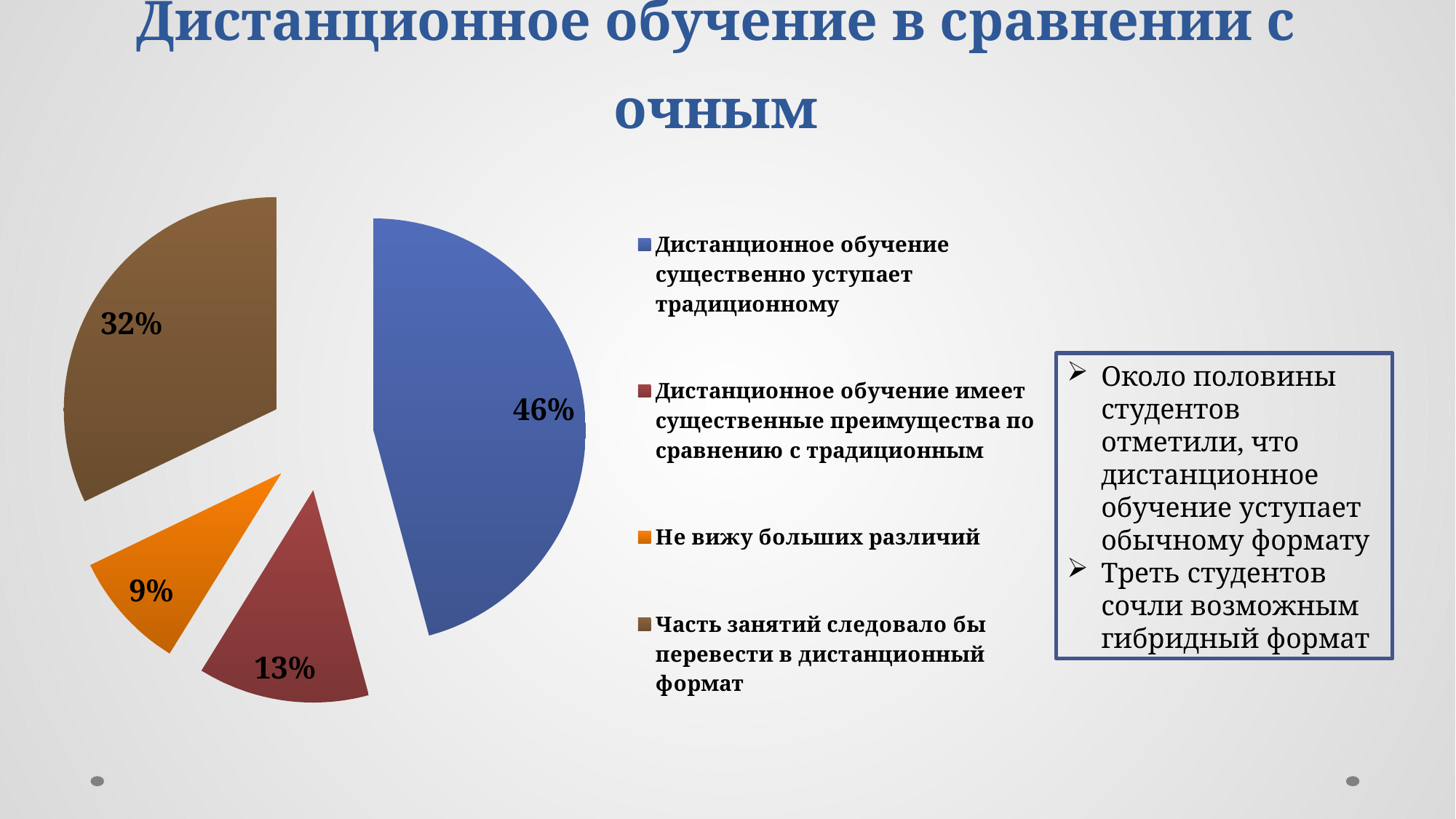
What share of the pie corresponds to "Не вижу больших различий"? 9% What is the difference in percentage points between the "Дистанционное обучение существенно уступает традиционному" slice and the "Часть занятий следовало бы перевести в дистанционный формат" slice? 14 What is the title of the slide containing the pie chart? Дистанционное обучение в сравнении с очным Which category has the largest slice of the pie? Дистанционное обучение существенно уступает традиционному How many slices does the pie chart have? 4 Which is larger: the share for "Дистанционное обучение имеет существенные преимущества по сравнению с традиционным" or the share for "Не вижу больших различий"? Дистанционное обучение имеет существенные преимущества по сравнению с традиционным What share of the pie corresponds to "Часть занятий следовало бы перевести в дистанционный формат"? 32% Which category has the smallest slice of the pie? Не вижу больших различий What colour is the slice labelled 32%? brown What share of the pie corresponds to "Дистанционное обучение имеет существенные преимущества по сравнению с традиционным"? 13% What type of chart is shown on the slide? pie chart What share of the pie corresponds to "Дистанционное обучение существенно уступает традиционному"? 46%